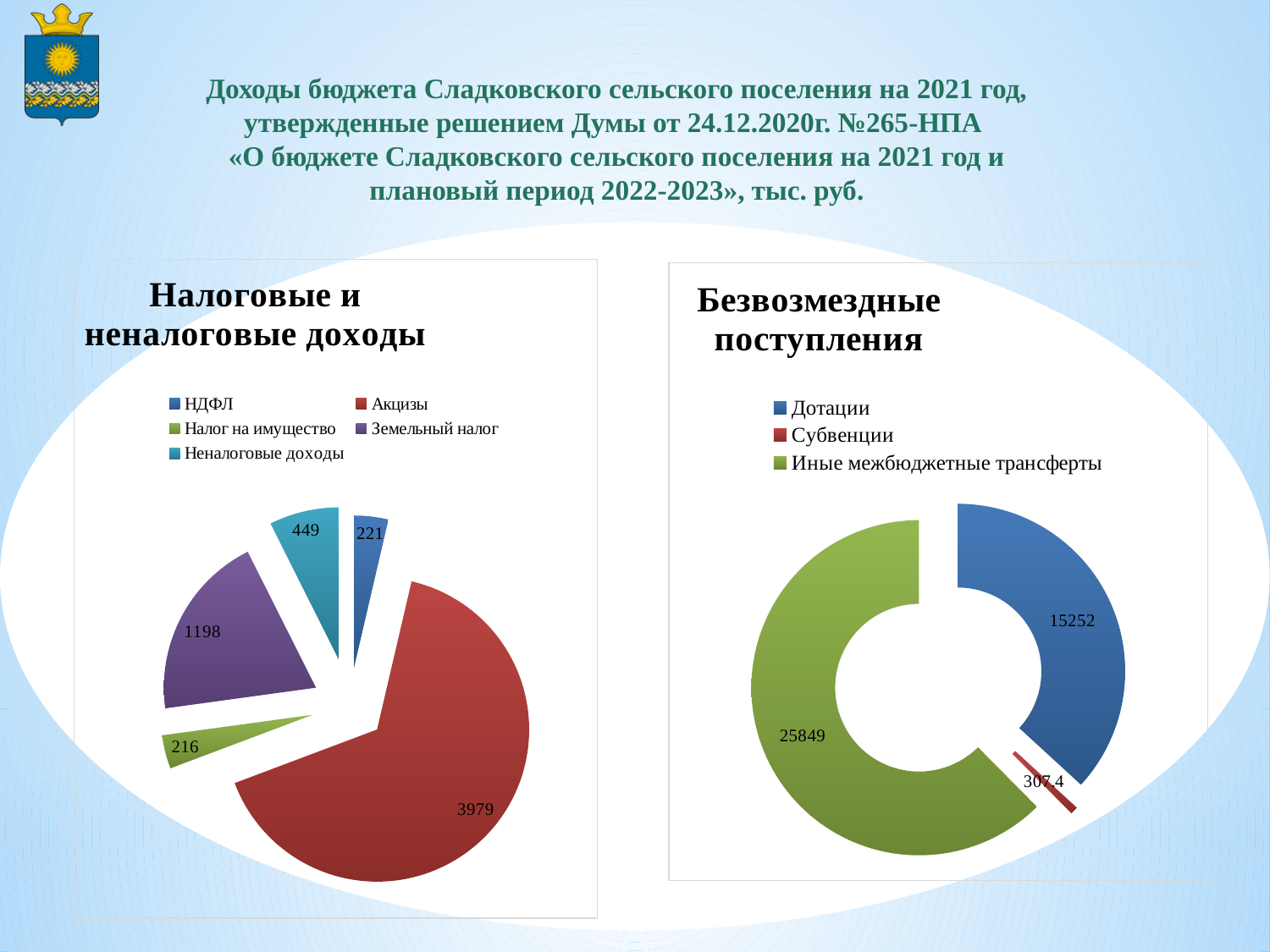
In the chart titled «Налоговые и неналоговые доходы», what is the value for Акцизы? 3979 In the chart titled «Безвозмездные поступления», what is the difference between Иные межбюджетные трансферты and Дотации? 10597 In the chart titled «Налоговые и неналоговые доходы», which category has the lowest value? Налог на имущество In the chart titled «Налоговые и неналоговые доходы», how many categories are shown? 5 In the chart titled «Безвозмездные поступления», which is larger: Дотации or Субвенции? Дотации In the chart titled «Налоговые и неналоговые доходы», what is the value for Земельный налог? 1198 In the chart titled «Безвозмездные поступления», what is the value for Дотации? 15252 In the chart titled «Налоговые и неналоговые доходы», what is the difference between Акцизы and Земельный налог? 2781 What kind of chart is the one titled «Налоговые и неналоговые доходы»? Pie chart In the chart titled «Безвозмездные поступления», what is the value for Субвенции? 307.4 In the chart titled «Налоговые и неналоговые доходы», which category has the highest value? Акцизы In the chart titled «Безвозмездные поступления», which category has the highest value? Иные межбюджетные трансферты